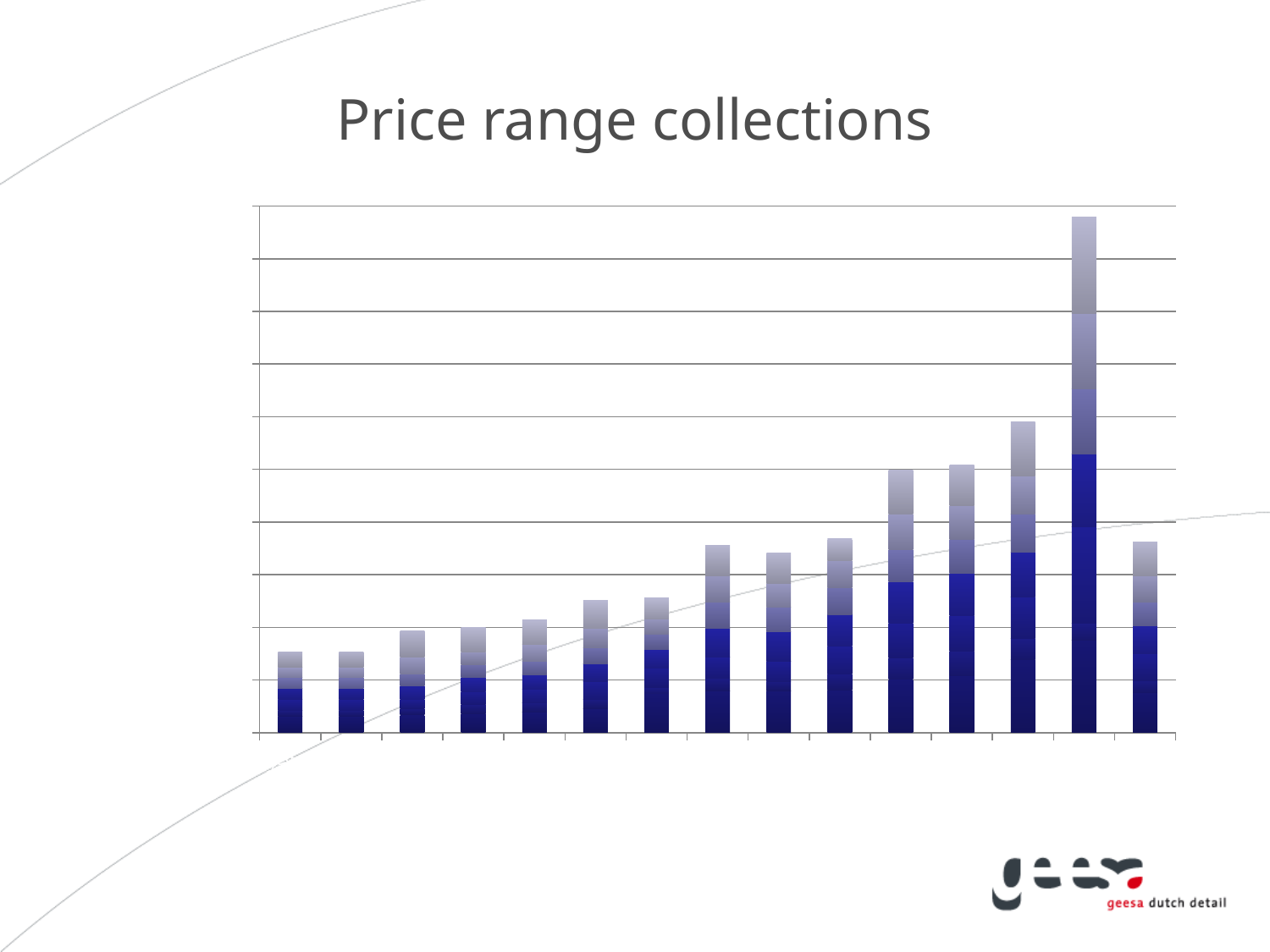
What is the title of the chart? Price range collections Which bar is the tallest in the chart? the second bar from the right Is the rightmost bar taller or shorter than the second bar from the right? shorter What kind of chart is shown on the slide? bar chart Do the bar heights generally rise or fall from left to right across the chart? rise How many bars are plotted in the chart? 15 Is the rightmost bar taller or shorter than the leftmost bar? taller Are the bars in the chart stacked or single-segment? stacked